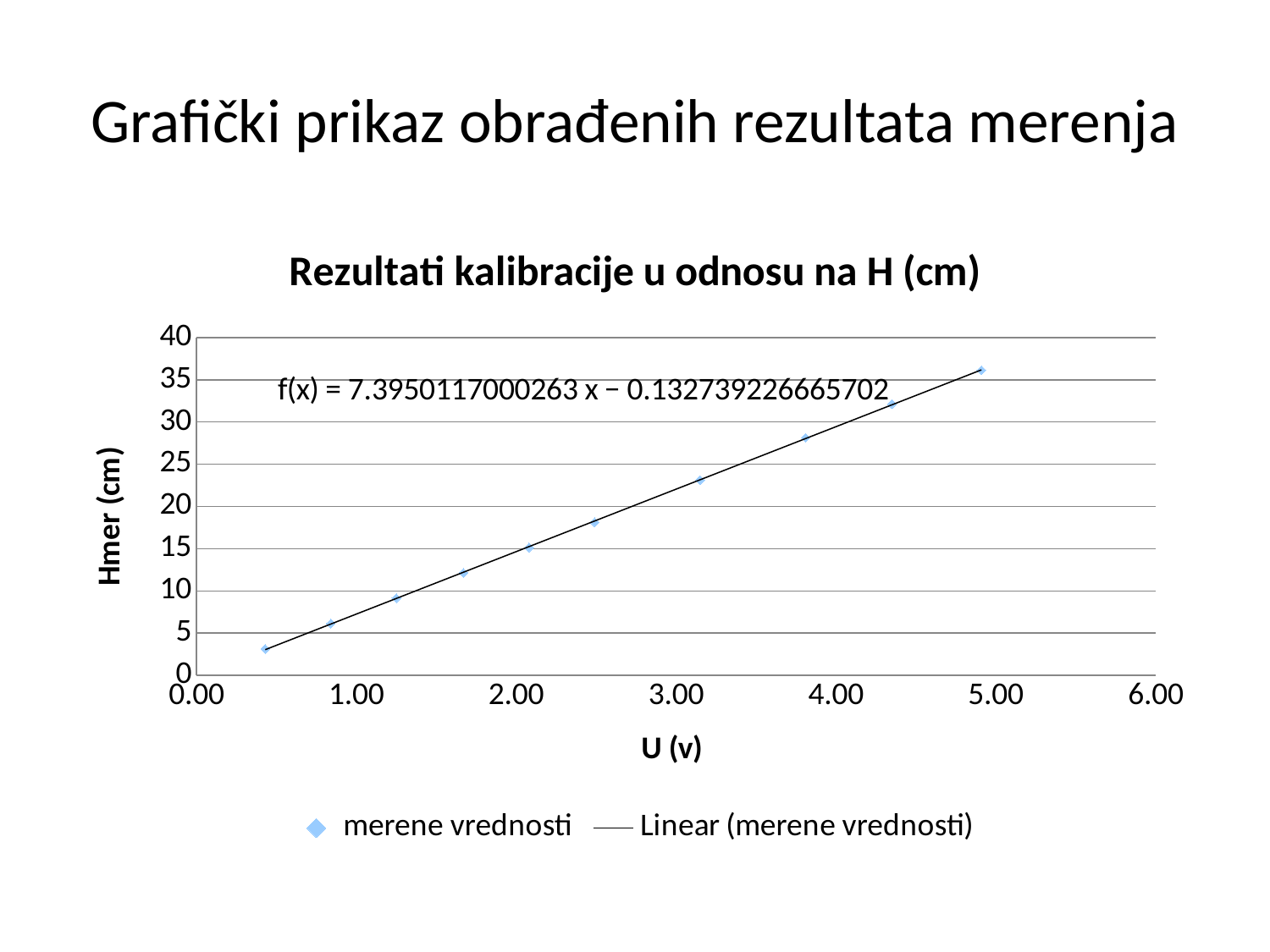
How many measured data points are plotted in the chart? 10 Which measured point has the highest Hmer (cm) value, the leftmost or the rightmost? The rightmost Is the Hmer (cm) value of the rightmost measured point greater or less than 30? greater Is the Hmer (cm) value of the measured point near U = 3.15 greater or less than 20? greater Is the Hmer (cm) value of the leftmost measured point greater or less than 5? less What kind of chart is shown on the slide? Scatter chart with a linear trendline Do the measured values rise or fall as U (v) increases? Rise How many entries does the chart legend list? 2 What trendline equation is displayed on the chart? f(x) = 7.3950117000263 x − 0.132739226665702 What is the title of the chart? Rezultati kalibracije u odnosu na H (cm)